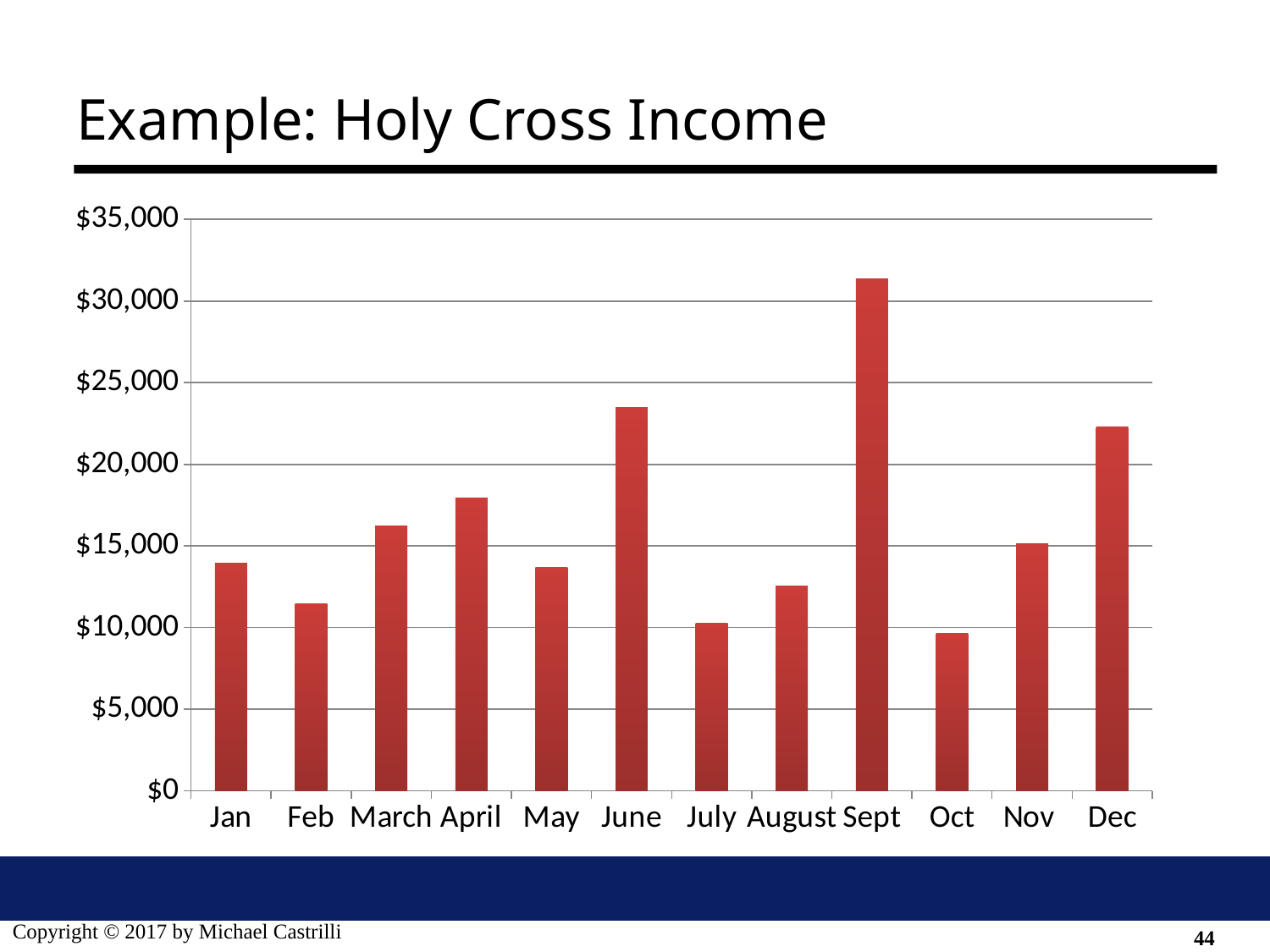
Is the value for Sept greater or less than $30,000? greater Is the value for Dec greater or less than $20,000? greater Which is larger, the income for June or for Dec? June What is the title of the slide containing the chart? Example: Holy Cross Income Which is larger, the income for March or for April? April What kind of chart is shown on the slide? bar chart Is the value for Feb greater or less than $10,000? greater Which month has the lowest income? Oct Which month has the highest income? Sept How many months are plotted on the chart? 12